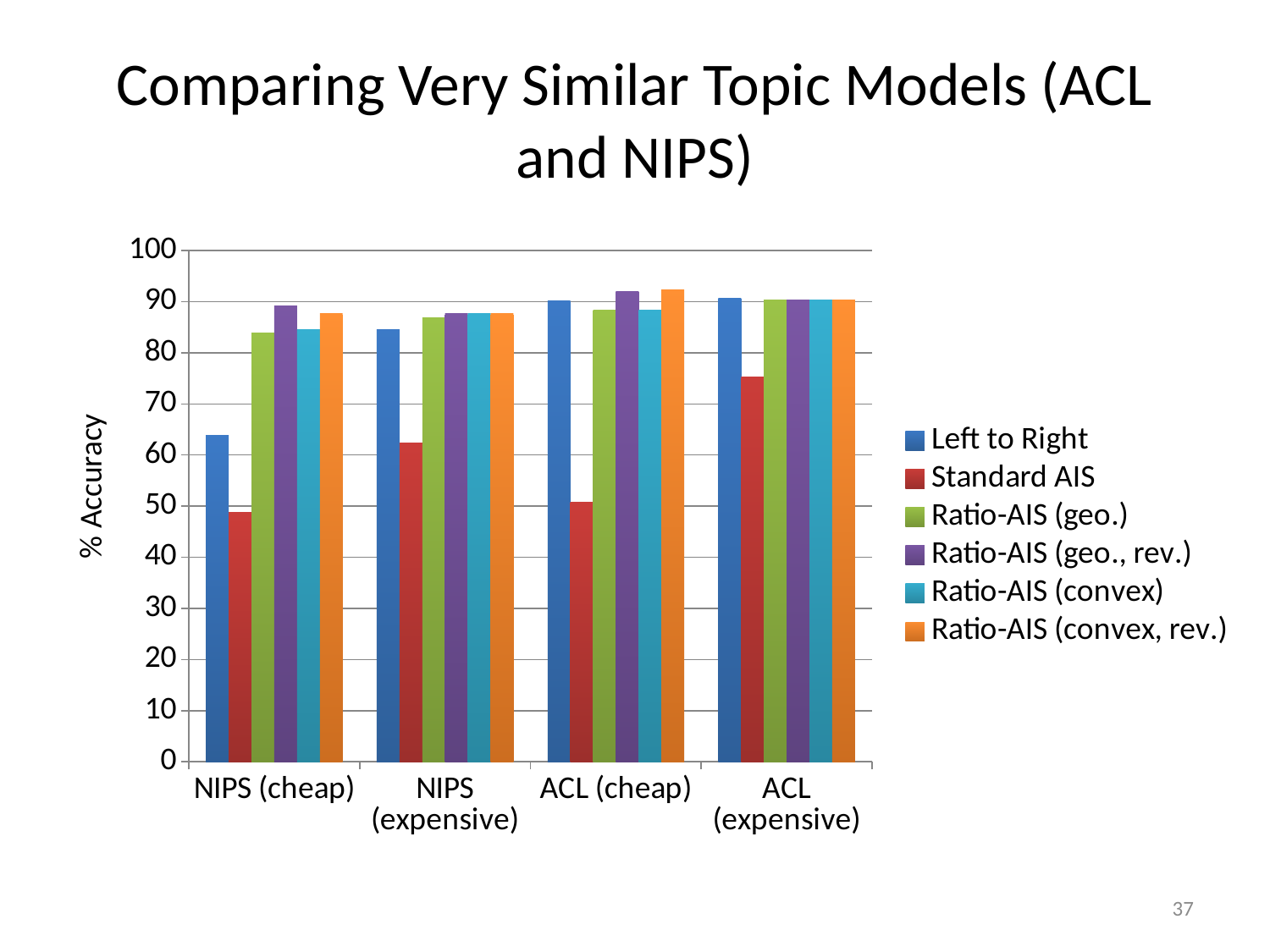
What kind of chart is shown on the slide? bar chart What is the label on the y axis? % Accuracy Is the Standard AIS value for ACL (expensive) greater or less than 70? greater Is the Standard AIS value for NIPS (cheap) greater or less than 60? less How many categories are shown on the x axis? 4 How many series does the legend list? 6 Which is larger: the Left to Right value for NIPS (cheap) or for NIPS (expensive)? NIPS (expensive) Is the Left to Right value for NIPS (cheap) greater or less than 60? greater Which series has the lowest value for NIPS (cheap)? Standard AIS Which is larger: the Standard AIS value for ACL (expensive) or for NIPS (cheap)? ACL (expensive) Which category has the highest Standard AIS value? ACL (expensive)